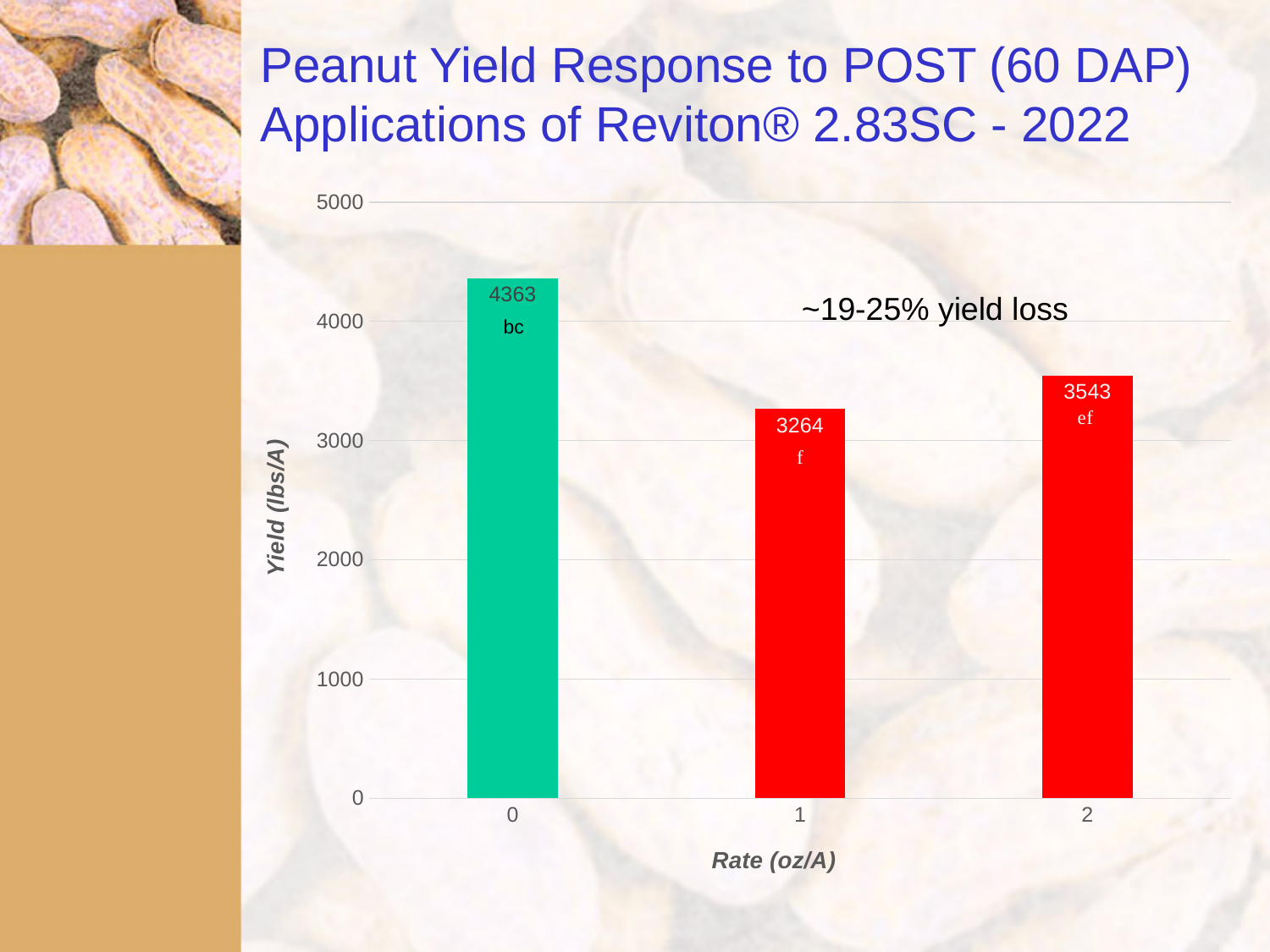
What kind of chart is shown on the slide? bar chart Which rate (oz/A) has the lowest yield? 1 What is the yield (lbs/A) at a rate of 0 oz/A? 4363 What is the yield (lbs/A) at a rate of 2 oz/A? 3543 What is the difference in yield between the 0 oz/A rate and the 1 oz/A rate? 1099 What is the yield (lbs/A) at a rate of 1 oz/A? 3264 What is the difference in yield between the 2 oz/A rate and the 1 oz/A rate? 279 How many rate categories are shown on the x axis? 3 Is the yield at the 0 oz/A rate greater or less than 4000? greater Which rate (oz/A) has the highest yield? 0 What approximate yield loss does the annotation on the chart state? ~19-25% yield loss Which has a higher yield, the 1 oz/A rate or the 2 oz/A rate? 2 oz/A